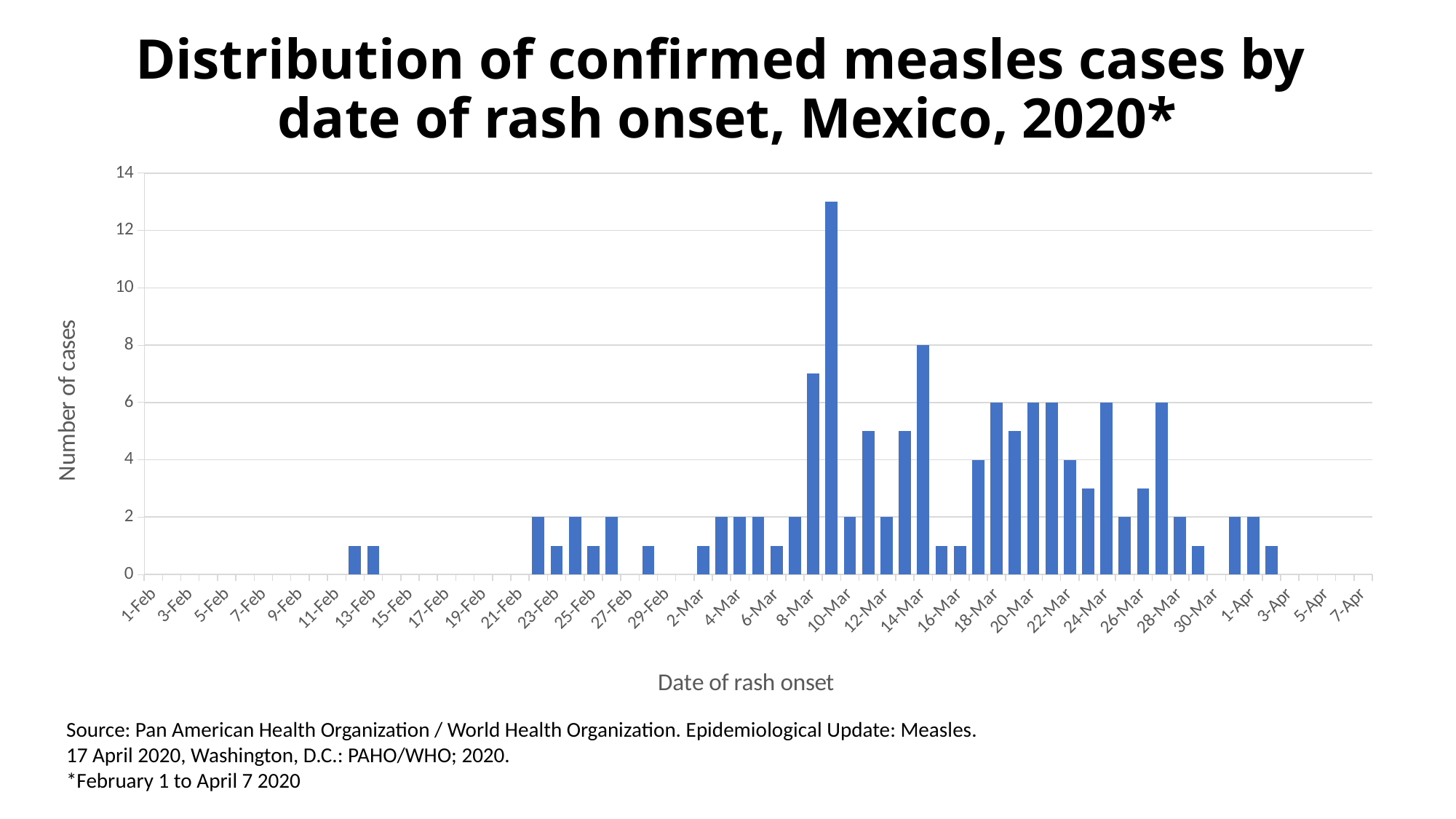
What is the number of cases for 18-Mar? 6 What is the label of the horizontal axis? Date of rash onset What is the number of cases for 24-Mar? 6 What is the number of cases for 14-Mar? 8 What is the number of cases for 22-Mar? 4 Is the tallest bar in the chart greater or less than 12? greater What is the difference in number of cases between 14-Mar and 22-Mar? 4 What kind of chart is shown on the slide? bar chart What is the label of the vertical axis? Number of cases What is the number of cases for 4-Mar? 2 Which has more cases, 14-Mar or 18-Mar? 14-Mar Is the value for 8-Mar greater or less than 6? greater